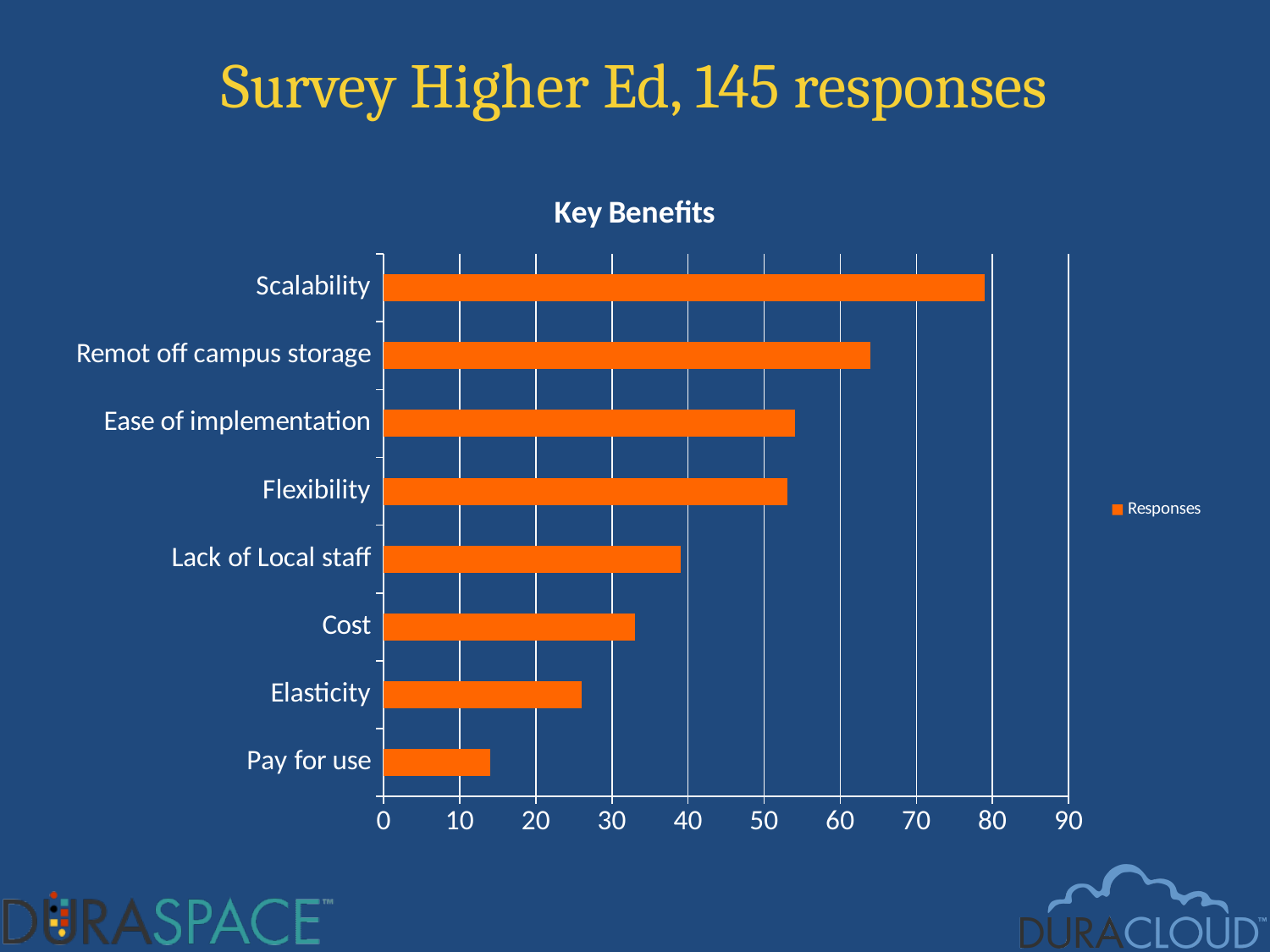
Is the value for Pay for use greater or less than 20? less Is the value for Scalability greater or less than 70? greater How many series does the legend list? 1 Is the value for Cost greater or less than 40? less Which category has the highest number of responses? Scalability What type of chart is shown on the slide? bar chart Which has more responses, Lack of Local staff or Elasticity? Lack of Local staff What is the name of the series shown in the legend? Responses What is the title of the chart? Key Benefits How many categories are plotted in the chart? 8 Which category has the lowest number of responses? Pay for use